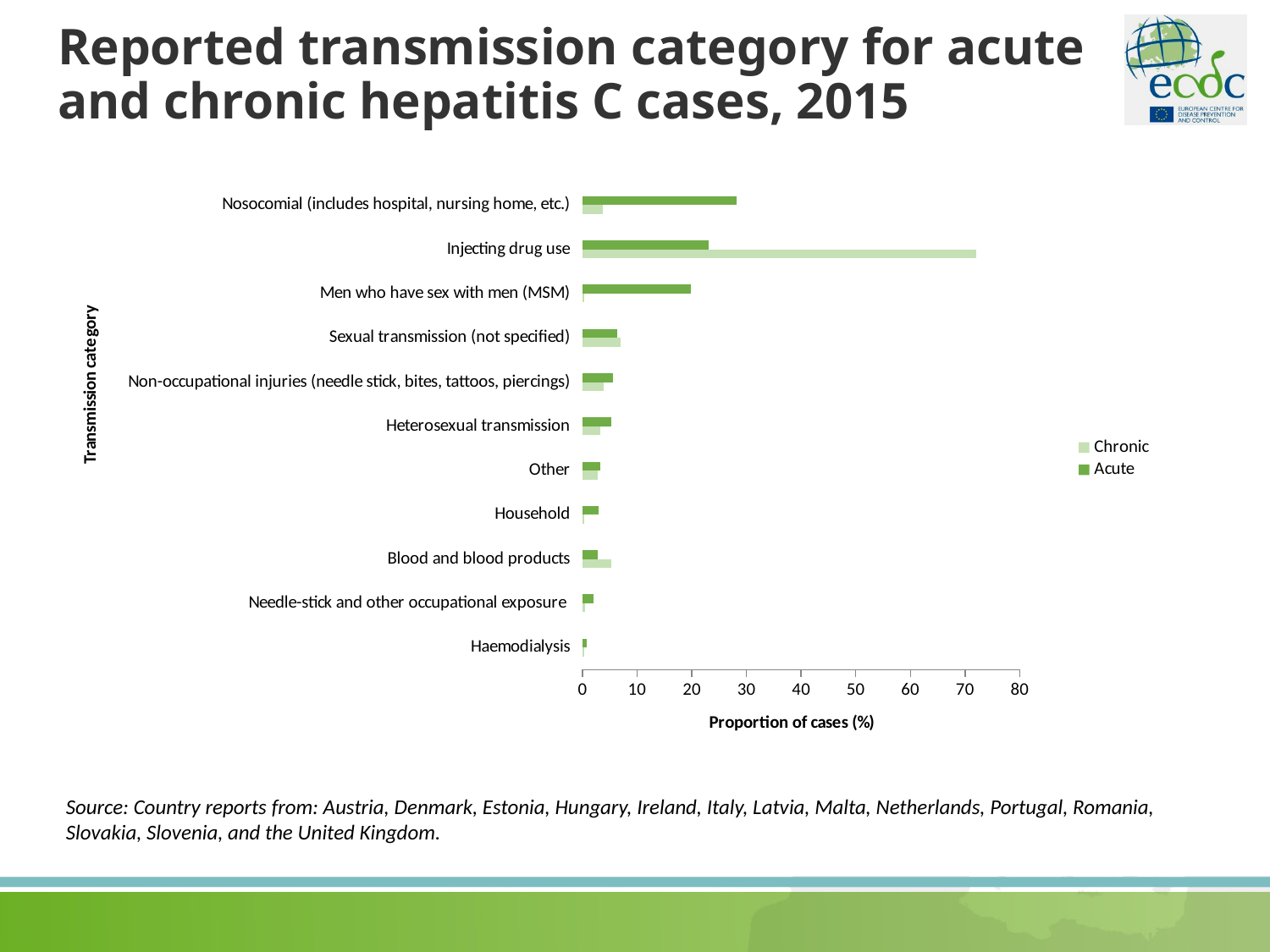
How many series does the legend list? 2 Which transmission category has the highest Chronic proportion? Injecting drug use Is the Acute value for Nosocomial (includes hospital, nursing home, etc.) greater or less than 20? greater For Injecting drug use, which is larger: the Chronic or the Acute proportion? Chronic Which transmission category has the highest Acute proportion? Nosocomial (includes hospital, nursing home, etc.) Is the Acute value for Men who have sex with men (MSM) greater or less than 30? less Is the Acute value for Injecting drug use greater or less than 20? greater What is the label of the horizontal axis? Proportion of cases (%) For Nosocomial (includes hospital, nursing home, etc.), which is larger: the Acute or the Chronic proportion? Acute How many transmission categories are plotted on the chart? 11 What kind of chart is shown on the slide? bar chart